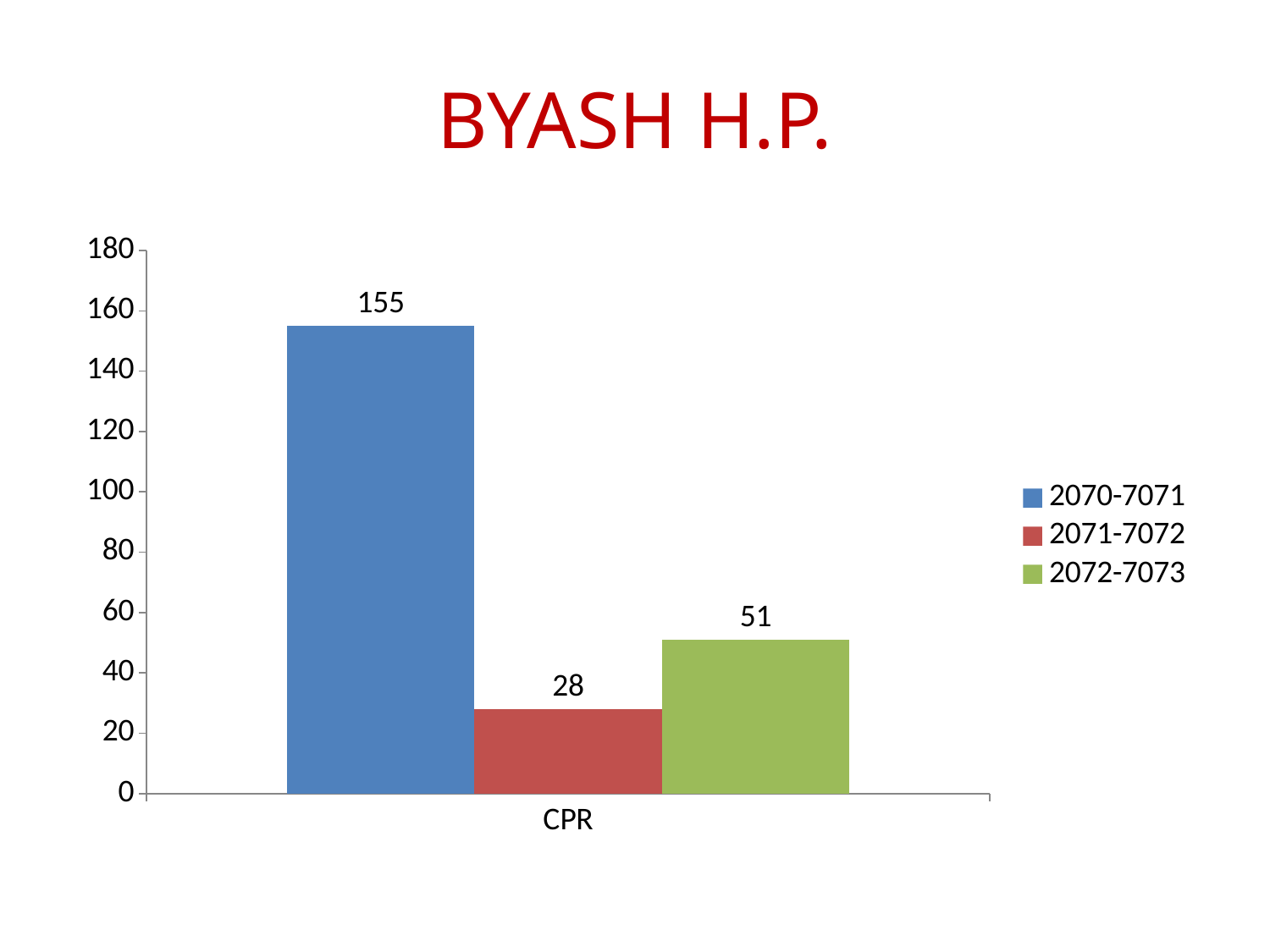
What is the value for the 2070-7071 series for CPR? 155 How many series does the legend list? 3 Which series has the lowest value for CPR? 2071-7072 What kind of chart is shown on the slide? bar chart Which is larger for CPR, the 2072-7073 value or the 2071-7072 value? 2072-7073 What is the title of the slide? BYASH H.P. Which series has the highest value for CPR? 2070-7071 What is the value for the 2072-7073 series for CPR? 51 Is the value for 2070-7071 greater or less than 140? greater What is the value for the 2071-7072 series for CPR? 28 What is the difference between the 2070-7071 value and the 2071-7072 value for CPR? 127 What is the difference between the 2072-7073 value and the 2071-7072 value for CPR? 23